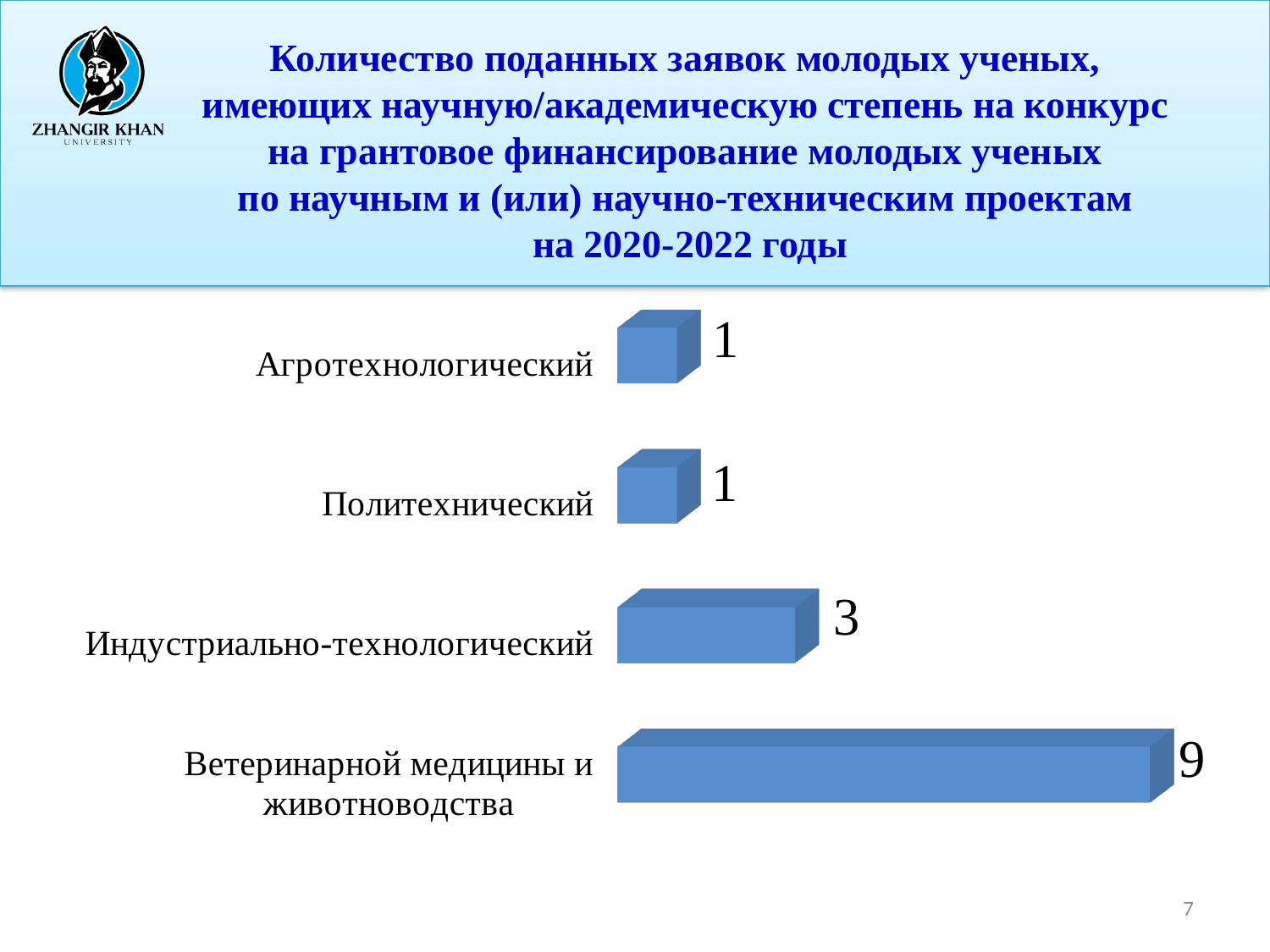
What kind of chart is shown on the slide? bar chart Which category has the highest value? Ветеринарной медицины и животноводства What is the difference between the values for Ветеринарной медицины и животноводства and Индустриально-технологический? 6 What is the difference between the values for Индустриально-технологический and Политехнический? 2 What is the total of all the values shown in the chart? 14 What is the value for Ветеринарной медицины и животноводства? 9 What is the value for Индустриально-технологический? 3 What is the value for Политехнический? 1 Which is larger, the value for Индустриально-технологический or the value for Агротехнологический? Индустриально-технологический Which two categories share the same value? Агротехнологический and Политехнический What is the value for Агротехнологический? 1 How many categories are shown in the chart? 4